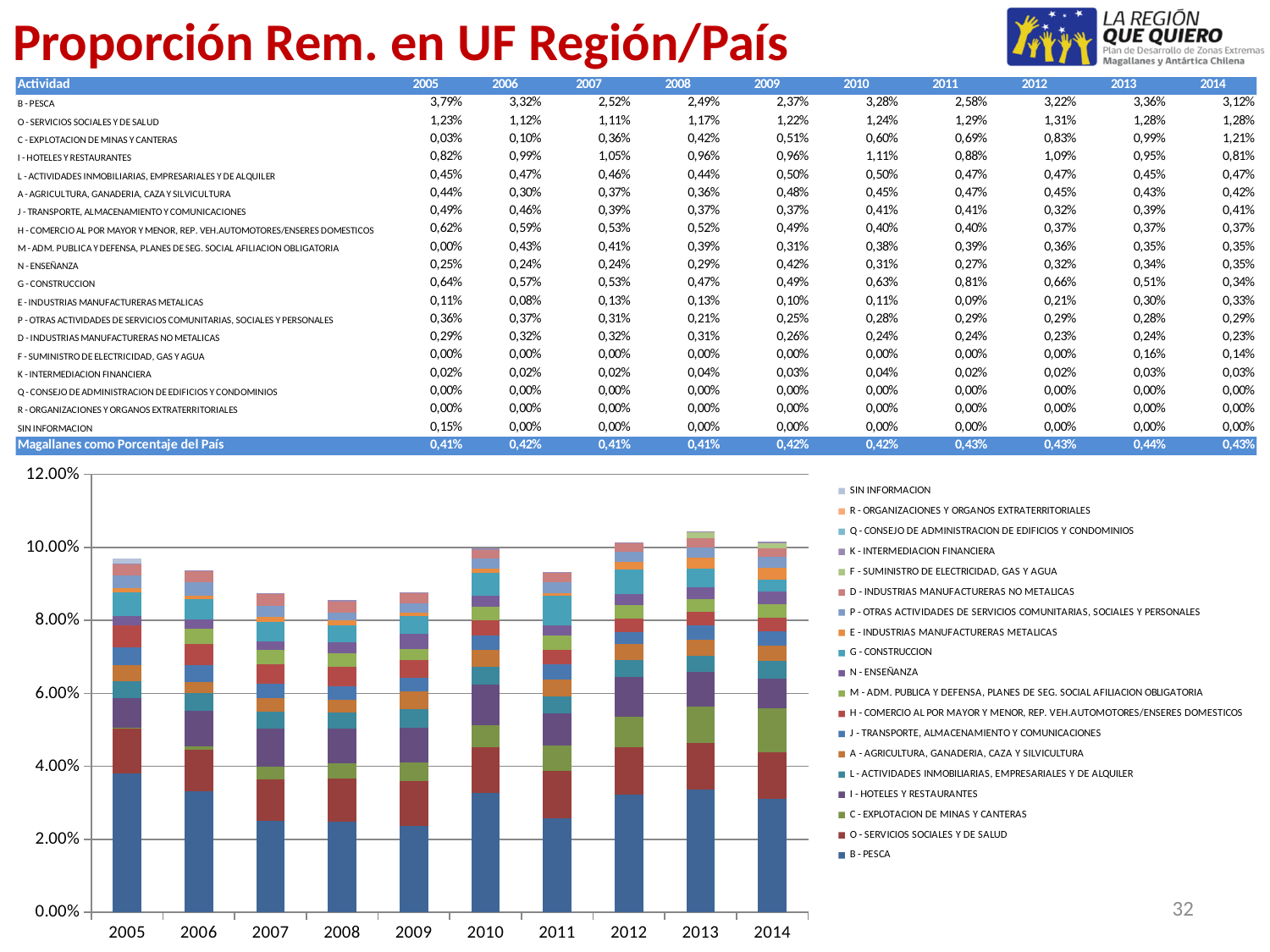
Is the total height of the stacked bar for 2008 greater or less than 10.00%? less How many years are shown along the x axis of the chart? 10 According to the table, what is the value for B - PESCA in 2005? 3,79% Which year has the tallest stacked bar? 2013 Is the total height of the stacked bar for 2013 greater or less than 10.00%? greater What kind of chart is shown on the slide? Stacked bar chart Which stacked bar is taller, 2008 or 2010? 2010 How many series does the chart legend list? 19 According to the table, what is the value for C - EXPLOTACION DE MINAS Y CANTERAS in 2014? 1,21% Which series is plotted at the bottom of each stacked bar? B - PESCA Is the total height of the stacked bar for 2005 greater or less than 8.00%? greater According to the table, what is the value of 'Magallanes como Porcentaje del País' in 2014? 0,43%